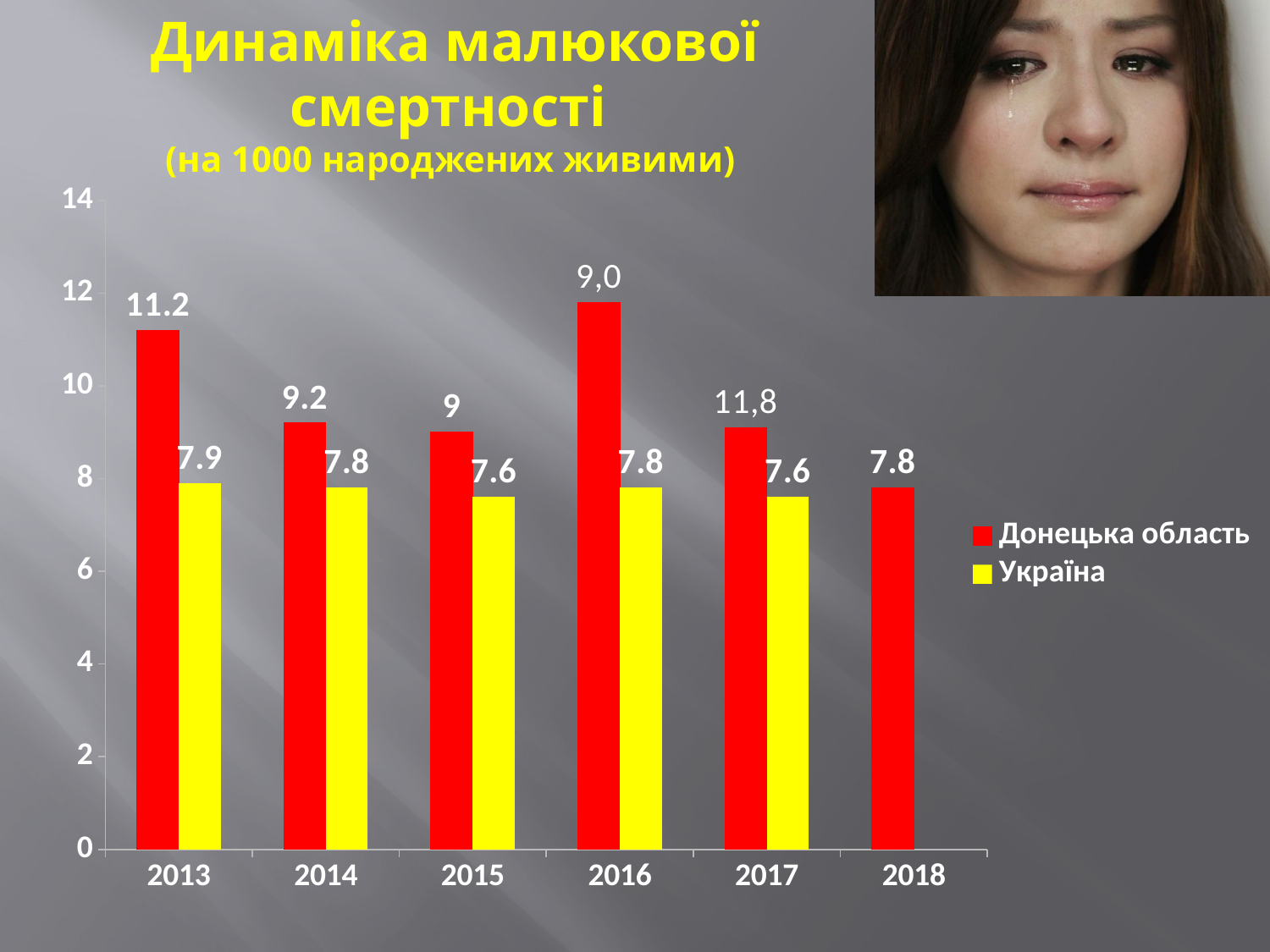
What is the value for Україна in 2013? 7.9 In 2014, which is larger: Донецька область or Україна? Донецька область How many series does the legend list? 2 How many years are shown on the x axis? 6 What is the value for Донецька область in 2013? 11.2 In which year is the value for Донецька область the lowest? 2018 What is the value for Донецька область in 2014? 9.2 What is the value for Донецька область in 2018? 7.8 What is the difference between Донецька область and Україна in 2013? 3.3 Which year has no bar for Україна? 2018 What is the value for Україна in 2015? 7.6 What kind of chart is shown on the slide? bar chart